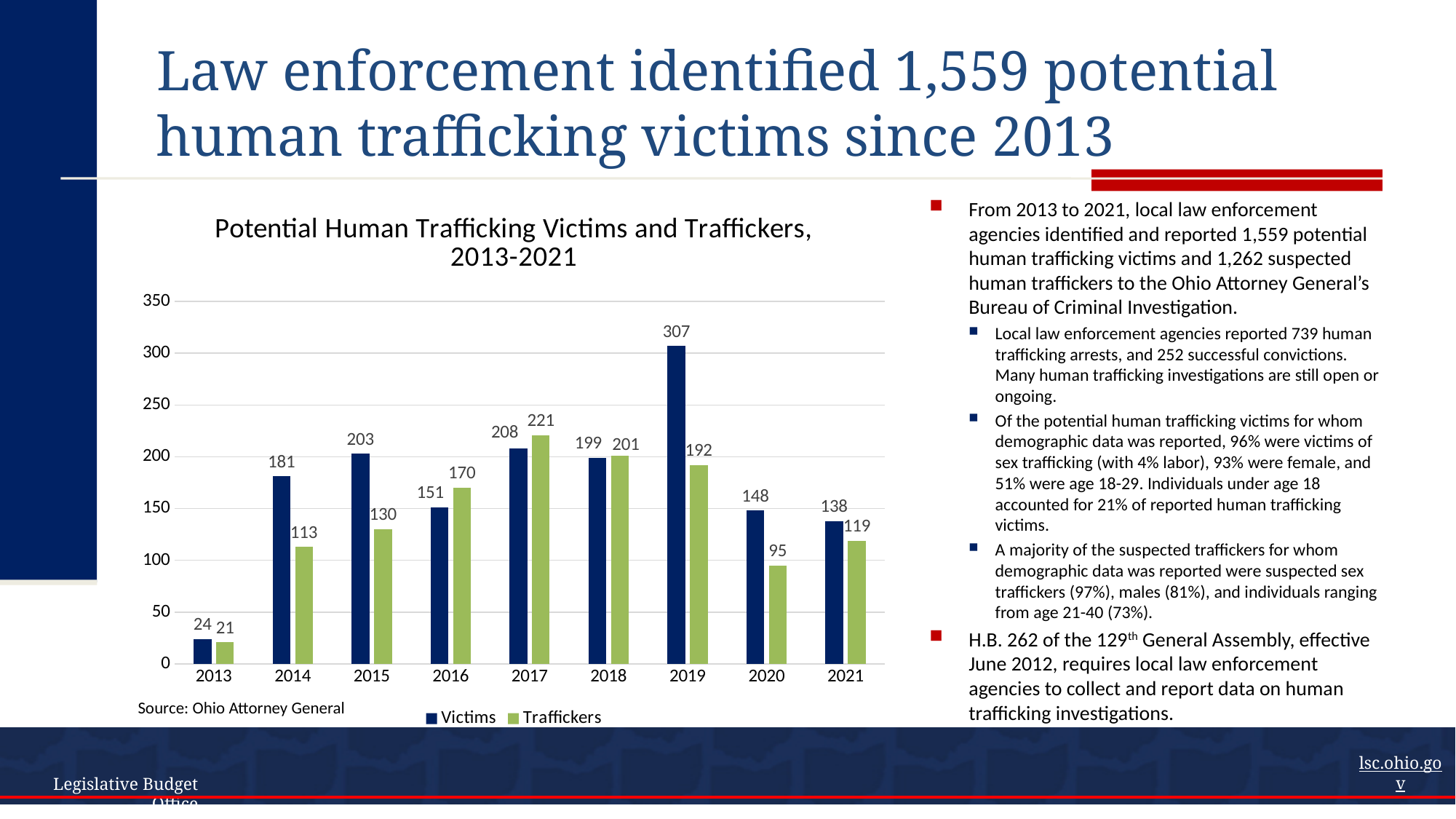
What is the number of Traffickers in 2014? 113 What is the number of Victims in 2019? 307 How many years are shown on the x axis? 9 In 2017, which is larger, Victims or Traffickers? Traffickers Which year has the highest number of Victims? 2019 How many series does the legend list? 2 What kind of chart is shown? Bar chart Do the Victims values rise or fall from 2019 to 2021? Fall Which year has the lowest number of Traffickers? 2013 Is the value for Traffickers in 2016 greater or less than 150? greater What is the title of the chart? Potential Human Trafficking Victims and Traffickers, 2013-2021 What is the difference between Victims and Traffickers in 2020? 53